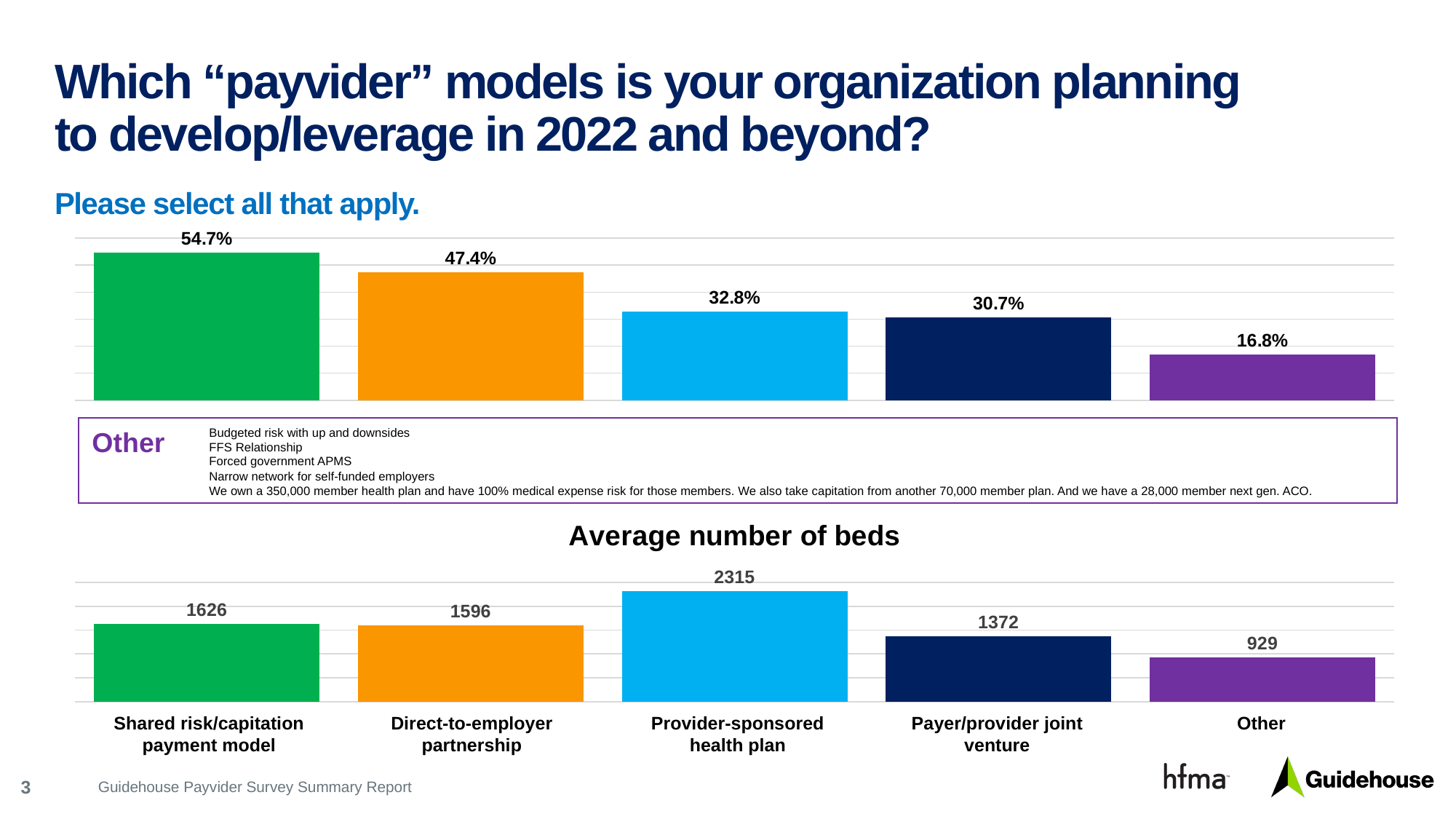
In the top chart, what percentage is shown for Payer/provider joint venture? 30.7% In the top chart, what is the difference between Shared risk/capitation payment model and Direct-to-employer partnership? 7.3% In the Average number of beds chart, what is the value for Provider-sponsored health plan? 2315 In the top chart, which category has the lowest percentage? Other In the top chart, do the values rise or fall from left to right? Fall In the top chart, which is larger: Provider-sponsored health plan or Other? Provider-sponsored health plan What type of chart is the Average number of beds chart? Bar chart In the top chart, what percentage of respondents selected Shared risk/capitation payment model? 54.7% In the Average number of beds chart, what is the value for Other? 929 In the Average number of beds chart, which category has the highest value? Provider-sponsored health plan How many categories are shown in the Average number of beds chart? 5 In the Average number of beds chart, what is the difference between Shared risk/capitation payment model and Payer/provider joint venture? 254